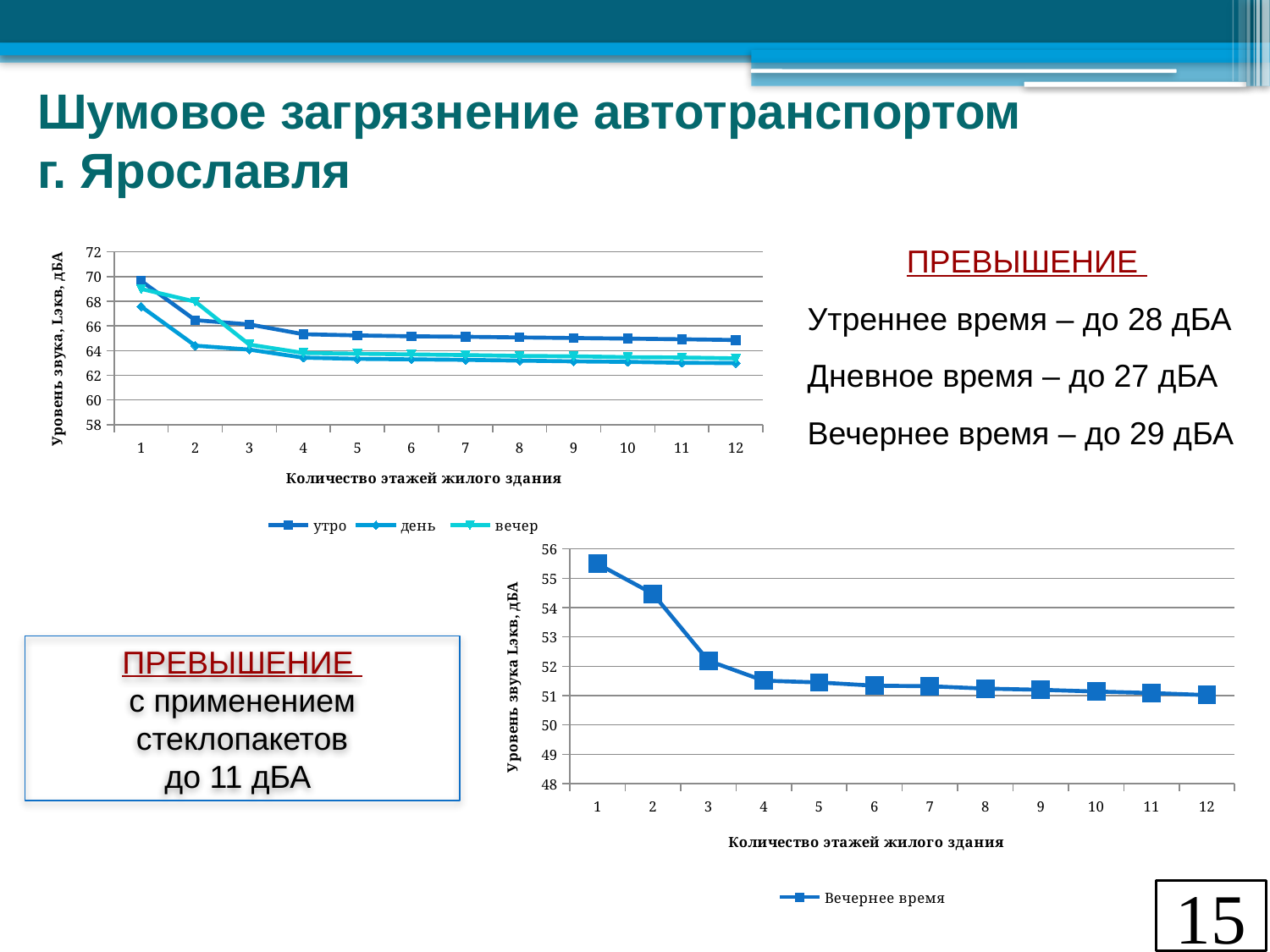
In the top-left chart, which series has the highest value at floor 2? вечер How many series does the legend of the top-left chart list? 3 What kind of chart is the top-left chart on the slide? line chart In the top-left chart, do the values of the утро series rise or fall as the number of floors increases? fall In the top-left chart, is the value of the день series at floor 2 greater or less than 66? less In the top-left chart, which series has the highest value at floor 12? утро In the top-left chart, is the value of the утро series at floor 12 greater or less than 64? greater In the bottom-right chart, at which floor is the sound level highest? 1 In the bottom-right chart, is the value at floor 1 greater or less than 55? greater What series name does the legend of the bottom-right chart show? Вечернее время How many floor categories are shown on the x axis of the top-left chart? 12